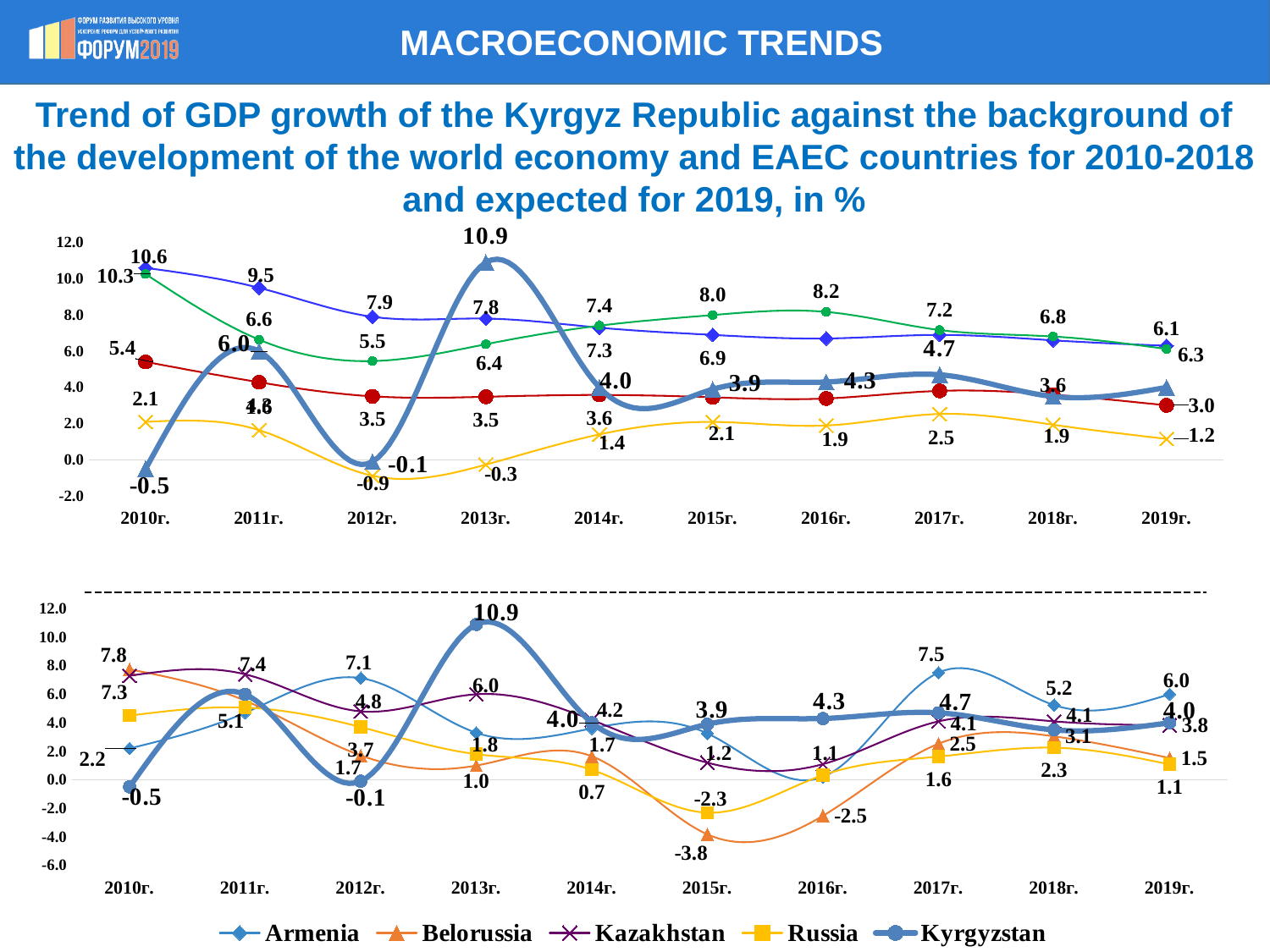
On the bottom chart, what is the value for Belorussia in 2015? -3.8 On the bottom chart, in which year does Belorussia reach its lowest value? 2015 On the bottom chart, how many series does the legend list? 5 On the bottom chart, what is the value for Kyrgyzstan in 2013? 10.9 On the bottom chart, what kind of chart is shown? line chart On the bottom chart, in which year does Kyrgyzstan reach its highest value? 2013 On the top chart, what is the value of the thick Kyrgyzstan line in 2013? 10.9 On the bottom chart, how many years are shown along the x axis? 10 On the bottom chart, what is the difference between Kyrgyzstan's value in 2013 and its value in 2012? 11.0 On the top chart, is the value for the thick Kyrgyzstan line in 2010 greater or less than 0.0? less On the bottom chart, what is the value for Armenia in 2017? 7.5 On the bottom chart, which is larger in 2017: the value for Armenia or the value for Kyrgyzstan? Armenia